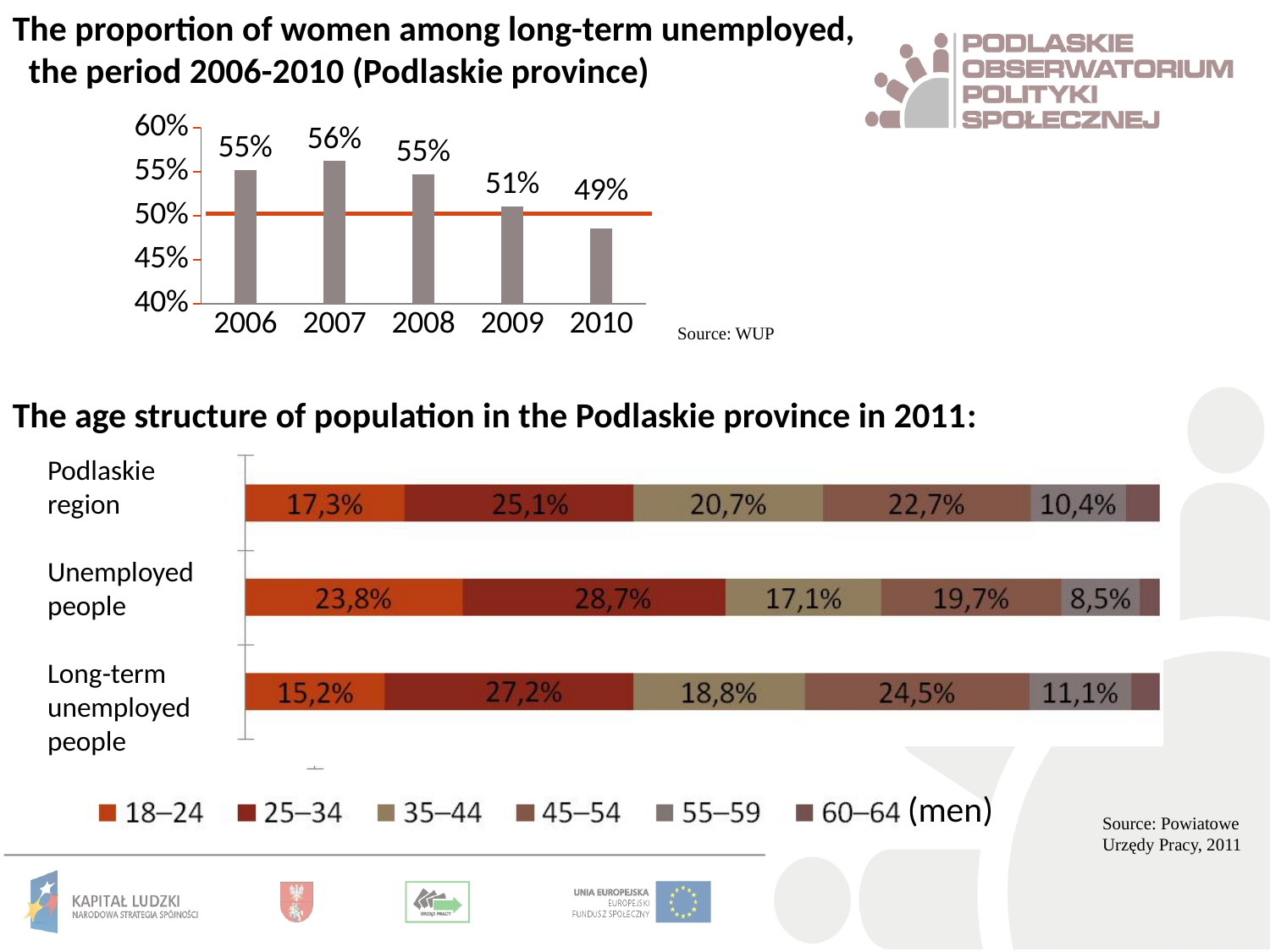
In the top chart on the proportion of women among long-term unemployed, what is the difference between the 2007 and 2010 values? 7% In the top chart on the proportion of women among long-term unemployed, what is the value for 2010? 49% In the bottom chart on the age structure of population in 2011, what is the share of the 25–34 age group among unemployed people? 28,7% In the bottom chart on the age structure of population in 2011, what is the share of the 45–54 age group among long-term unemployed people? 24,5% In the top chart on the proportion of women among long-term unemployed, which year has the lowest value? 2010 What kind of chart is the top chart on the proportion of women among long-term unemployed? bar chart In the top chart on the proportion of women among long-term unemployed, how many years are shown on the x axis? 5 In the top chart on the proportion of women among long-term unemployed, which year has the highest value? 2007 In the top chart on the proportion of women among long-term unemployed, what is the value for 2007? 56% In the top chart on the proportion of women among long-term unemployed, do the values generally rise or fall from 2007 to 2010? fall In the bottom chart on the age structure of population in 2011, which is larger: the 18–24 share for unemployed people or for long-term unemployed people? unemployed people In the bottom chart on the age structure of population in 2011, how many age groups does the legend list? 6